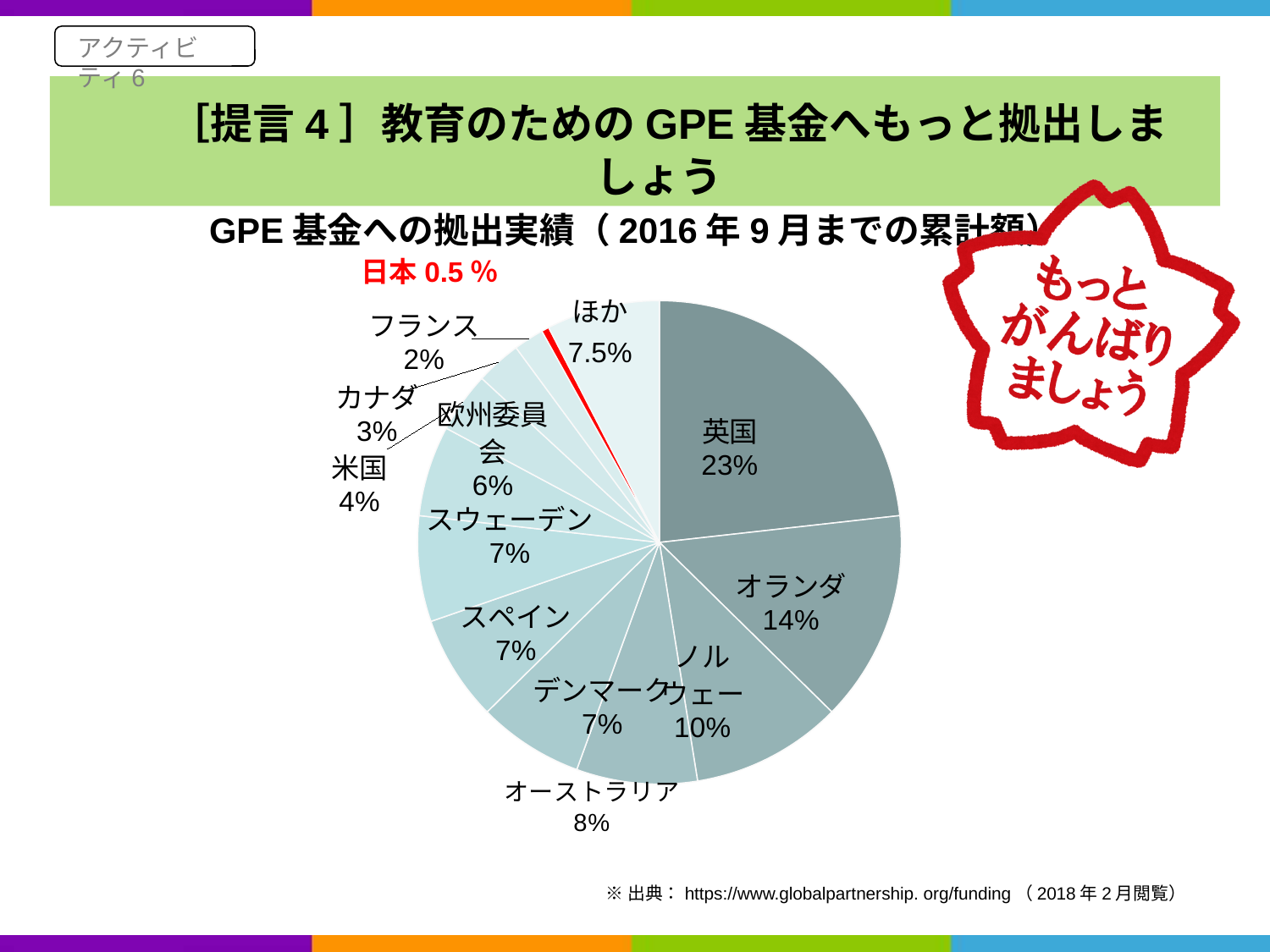
What is the value shown for 欧州委員会? 6% What share of GPE fund contributions does 英国 account for? 23% What is the title of the chart? GPE基金への拠出実績（2016年9月までの累計額） What kind of chart is shown on the slide? pie chart How many slices does the pie chart have? 13 What percentage is shown for 日本? 0.5% Which country has the largest slice of the pie? 英国 Which is larger, the share for オーストラリア or the share for 米国? オーストラリア Which labelled slice is the smallest? 日本 What is the difference between the shares of 英国 and オランダ? 9% What is the value shown for ノルウェー? 10% What is the value shown for オランダ? 14%